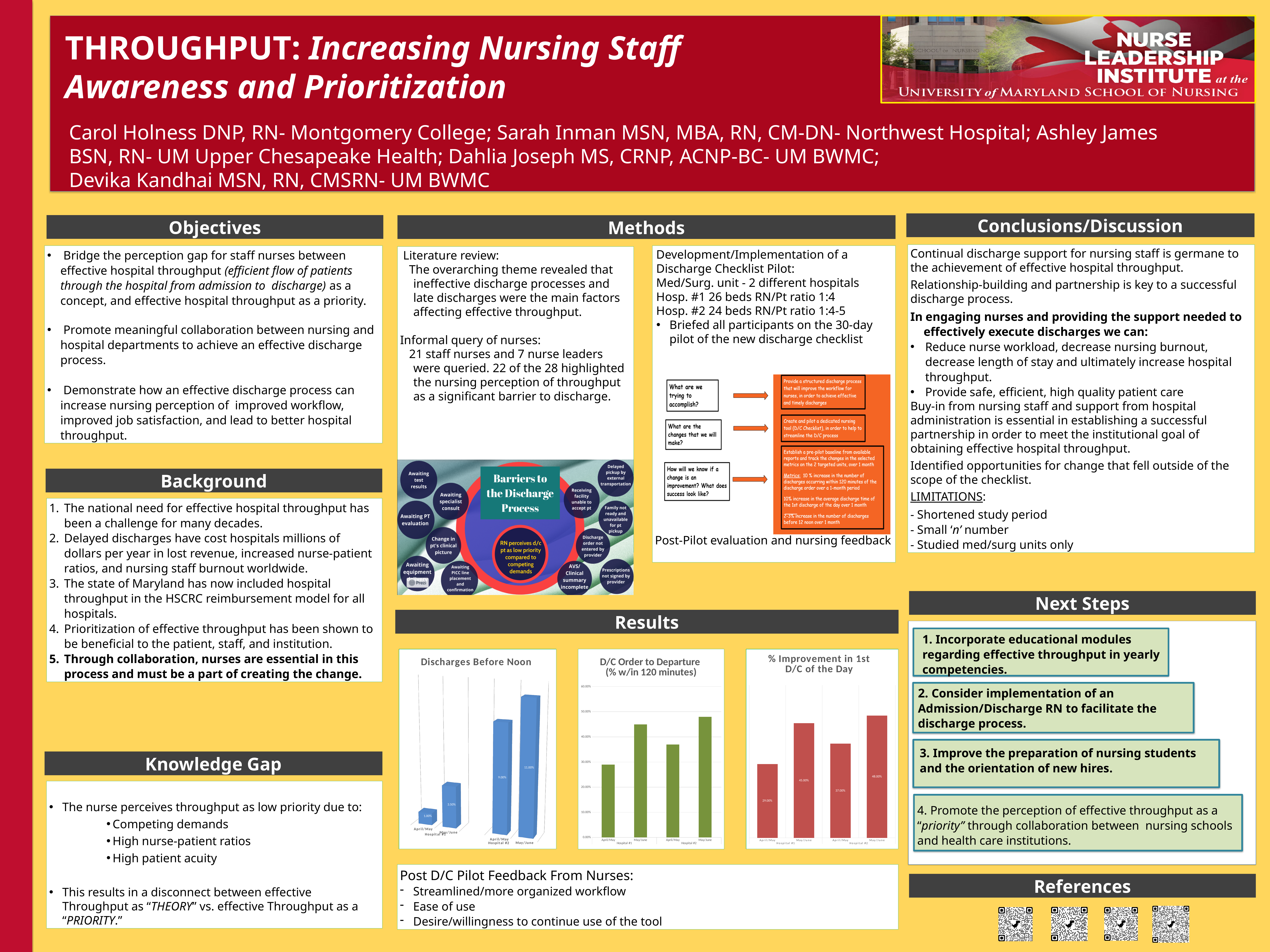
In the 'D/C Order to Departure (% w/in 120 minutes)' chart, which is larger, Hospital #1 May/June or Hospital #2 April/May? Hospital #1 May/June In the '% Improvement in 1st D/C of the Day' chart, what is the value for Hospital #2 in April/May? 37.00% In the 'D/C Order to Departure (% w/in 120 minutes)' chart, is the value for Hospital #1 April/May greater or less than 40.00%? less In the 'Discharges Before Noon' chart, which bar is the highest? Hospital #2 May/June In the 'Discharges Before Noon' chart, what is the value for Hospital #1 in April/May? 1.00% In the 'Discharges Before Noon' chart, what is the difference between Hospital #2 May/June and Hospital #2 April/May? 2.00% In the 'Discharges Before Noon' chart, what is the value for Hospital #1 in May/June? 3.50% In the 'Discharges Before Noon' chart, what is the value for Hospital #2 in May/June? 11.00% In the '% Improvement in 1st D/C of the Day' chart, which bar is the lowest? Hospital #1 April/May In the '% Improvement in 1st D/C of the Day' chart, what is the value for Hospital #1 in May/June? 45.00% How many bars are plotted in the 'D/C Order to Departure (% w/in 120 minutes)' chart? 4 In the '% Improvement in 1st D/C of the Day' chart, what is the difference between Hospital #2 May/June and Hospital #1 April/May? 19.00%